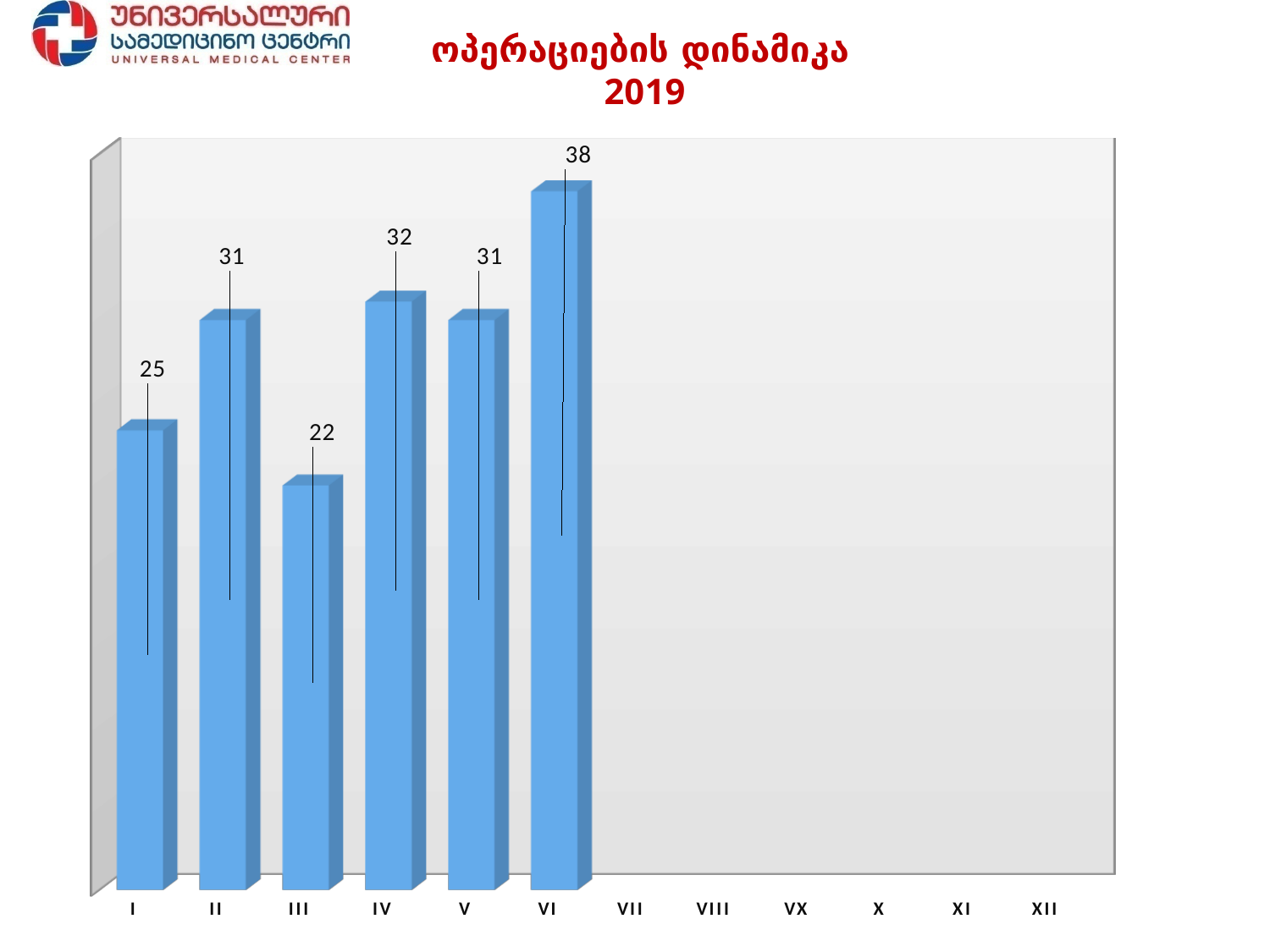
What is the difference between the values for IV and III? 10 Which is larger, the value for II or the value for III? II Which category has the highest value? VI What is the difference between the values for VI and I? 13 What is the value for category IV? 32 What kind of chart is shown on the slide? bar chart What is the value for category I? 25 What year is shown in the chart title? 2019 What is the value for category VI? 38 Which category has the lowest value among the bars shown? III How many categories are labelled on the x axis? 12 What is the value for category III? 22